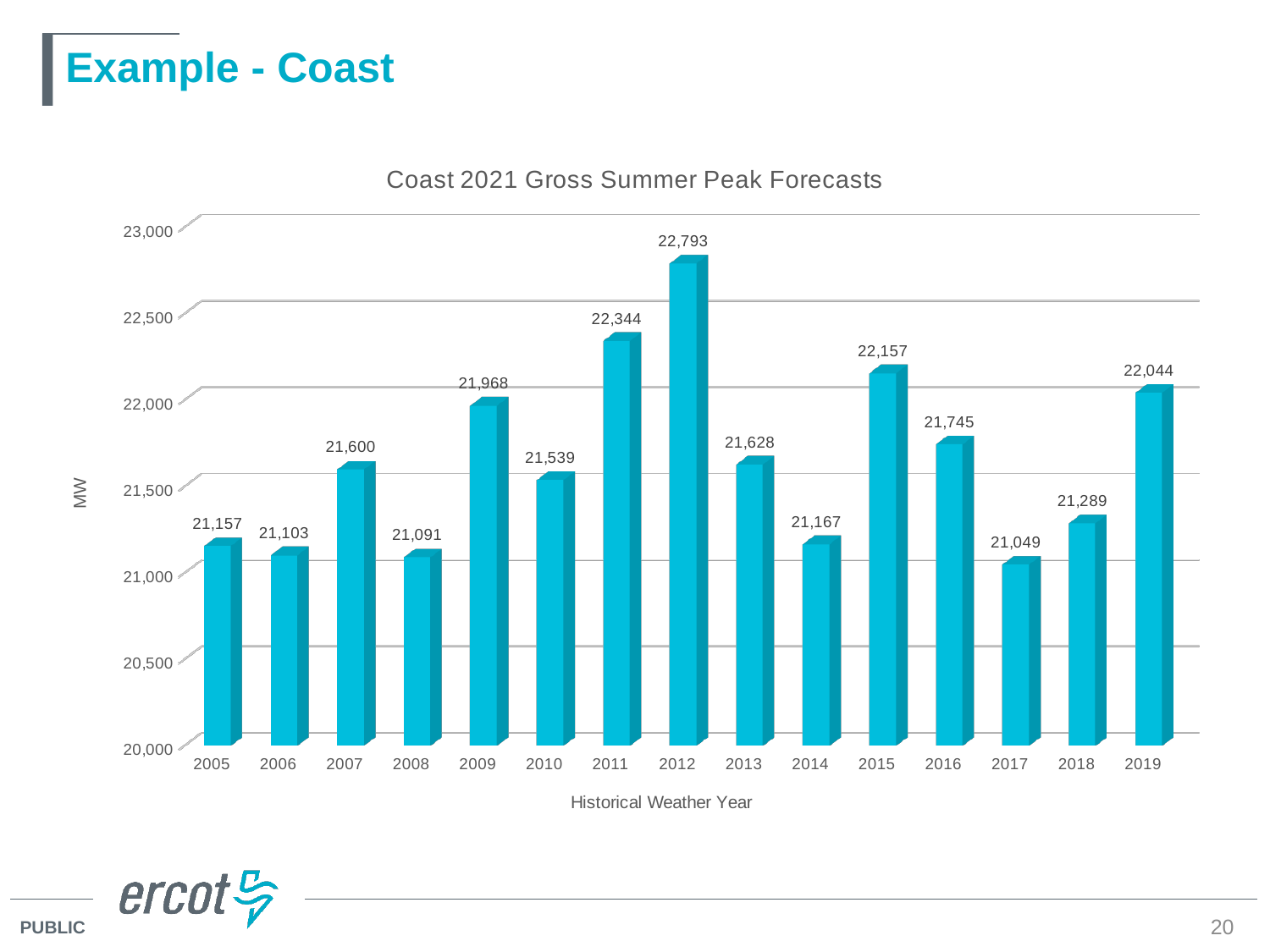
What is the forecast value for historical weather year 2012? 22,793 What is the title of the chart? Coast 2021 Gross Summer Peak Forecasts Which historical weather year has the highest forecast value? 2012 Which historical weather year has the lowest forecast value? 2017 What is the forecast value for historical weather year 2009? 21,968 What is the difference between the forecast values for 2012 and 2017? 1,744 How many historical weather years are shown on the x axis? 15 What is the forecast value for historical weather year 2017? 21,049 Which has a larger forecast value, 2011 or 2016? 2011 What is the difference between the forecast values for 2015 and 2014? 990 What kind of chart is shown on the slide? Bar chart Is the value for 2019 greater or less than 22,000? greater